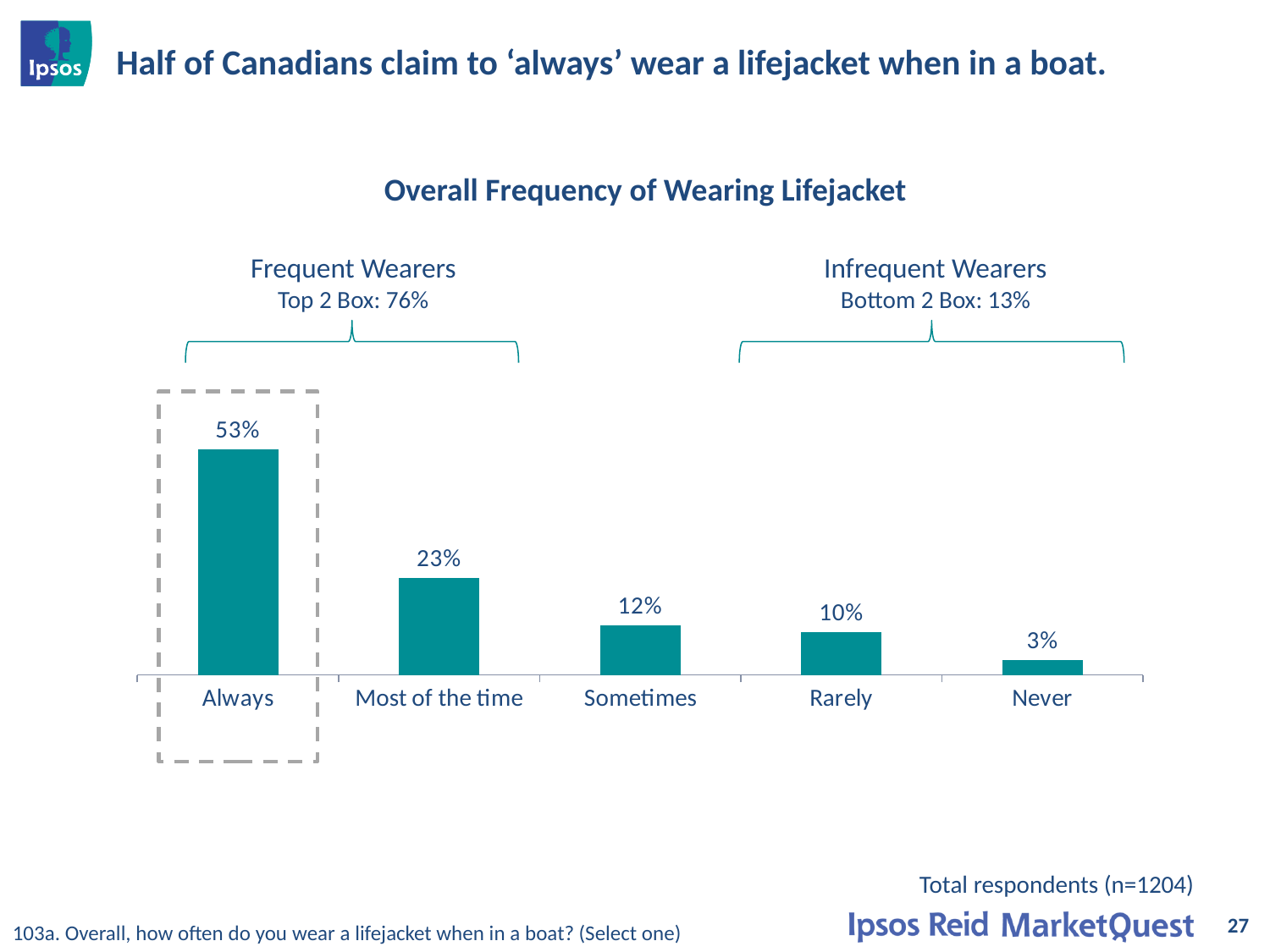
Which category has the lowest value? Never Which is larger, the value for 'Sometimes' or the value for 'Rarely'? Sometimes What is the difference between the 'Rarely' and 'Never' values? 7% Which category has the highest value? Always What percentage of respondents say they 'Always' wear a lifejacket? 53% How many categories are shown on the x axis? 5 What is the value for 'Most of the time'? 23% What is the difference between the 'Always' and 'Most of the time' values? 30% What kind of chart is shown on the slide? Bar chart What is the value for 'Sometimes'? 12% What is the title of the chart? Overall Frequency of Wearing Lifejacket What is the value for 'Never'? 3%